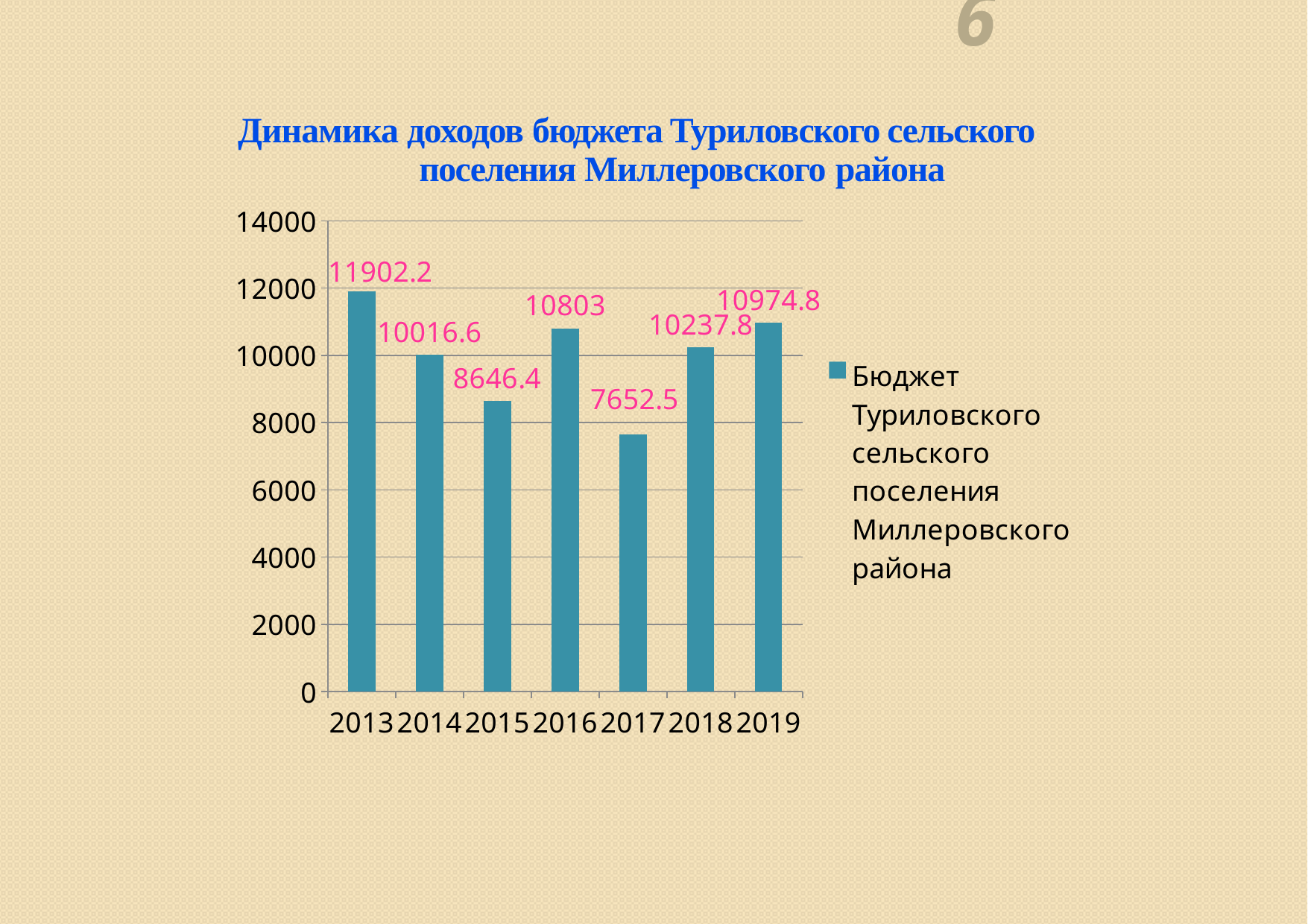
How many series does the legend list? 1 What kind of chart is shown on the slide? bar chart What is the value for 2019? 10974.8 What is the title of the chart? Динамика доходов бюджета Туриловского сельского поселения Миллеровского района Which year has the lowest value? 2017 Which is larger, the value for 2016 or the value for 2018? 2016 What is the value for 2017? 7652.5 What is the value for 2013? 11902.2 How many years are shown on the x axis? 7 What is the difference between the values for 2013 and 2017? 4249.7 Is the value for 2015 greater or less than 10000? less Which year has the highest value? 2013